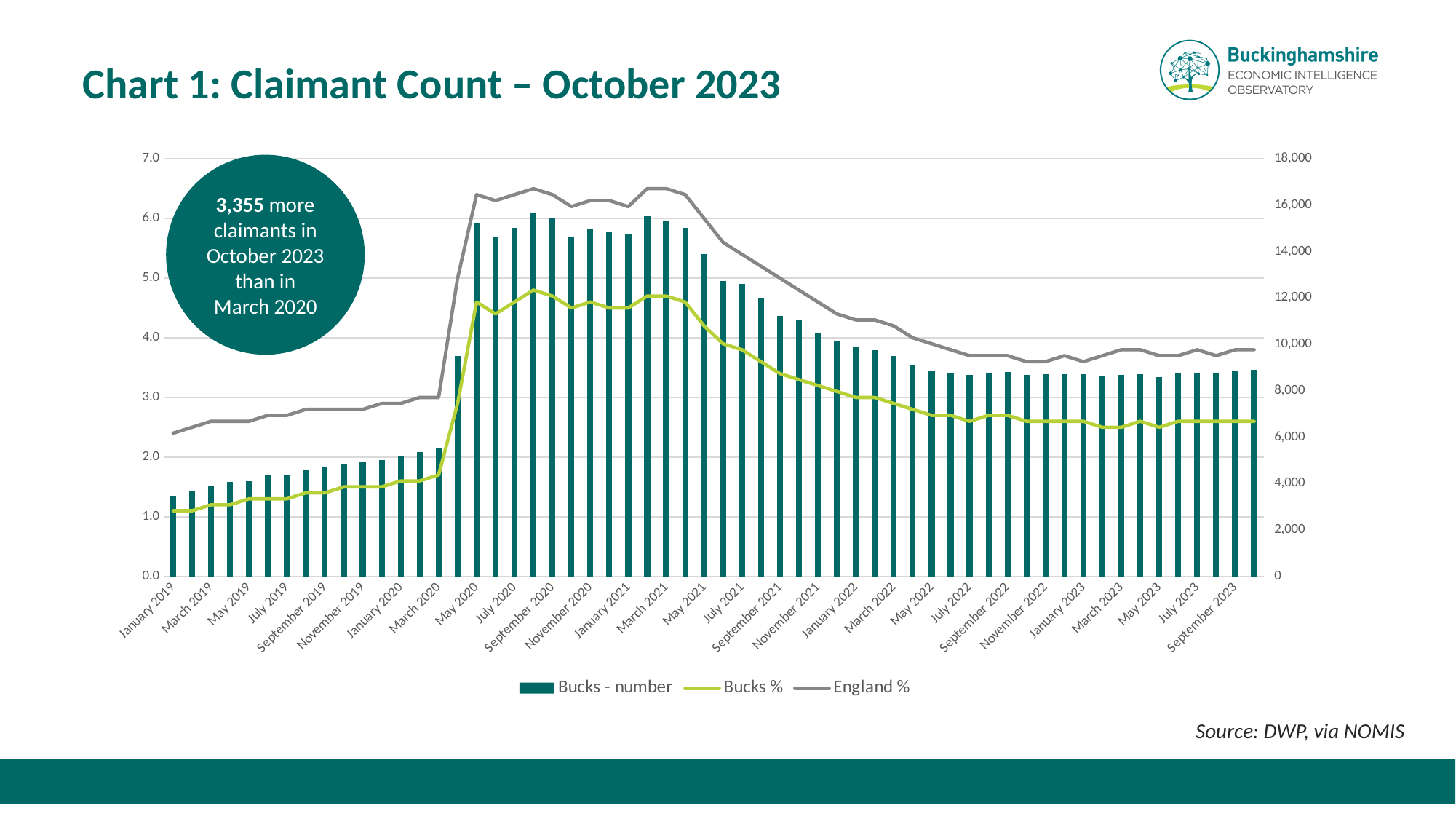
Is the value for England % in January 2019 greater or less than 3.0? less What kind of chart is shown on the slide? A combination bar and line chart How many series does the legend list? 3 Do the Bucks - number bars rise or fall from January 2019 to March 2020? rise Is the value for Bucks - number in January 2019 greater or less than 4,000? less Which is larger in July 2021, the England % value or the Bucks % value? England % According to the callout, how many more claimants were there in October 2023 than in March 2020? 3,355 Which month has the lowest value for Bucks - number? January 2019 Is the value for England % in May 2020 greater or less than 6.0? greater Which series is plotted as bars? Bucks - number